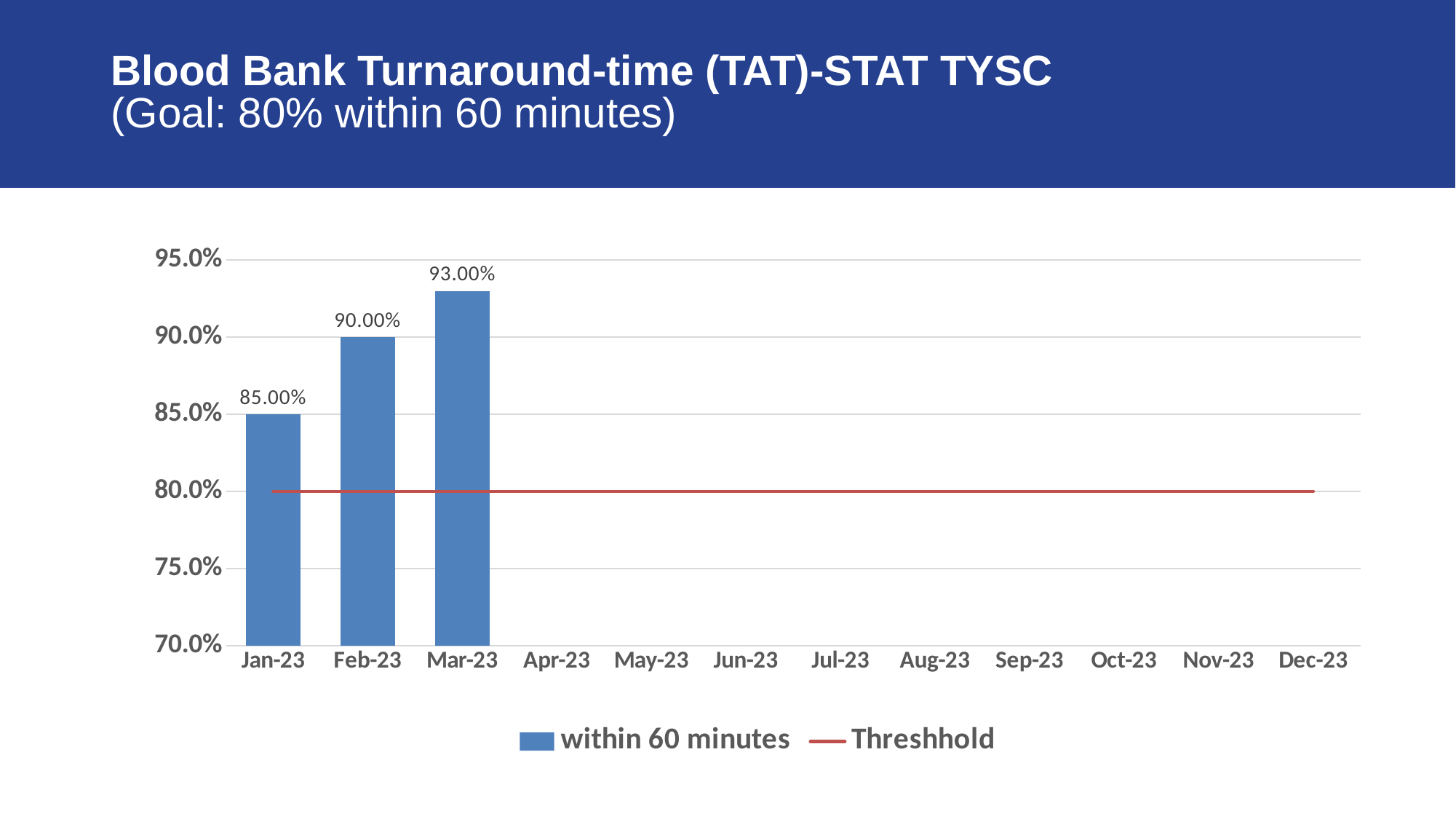
What is the value for Jan-23 in the 'within 60 minutes' series? 85.00% Which is larger, the Feb-23 value or the Jan-23 value? Feb-23 What is the value for Mar-23 in the 'within 60 minutes' series? 93.00% Which month has the highest 'within 60 minutes' value? Mar-23 How many series does the legend list? 2 Is the value for Jan-23 greater or less than 80.0%? greater How many months have a bar plotted on the chart? 3 What is the difference between the Mar-23 and Jan-23 'within 60 minutes' values? 8.00% What kind of chart is used for the 'within 60 minutes' series? Bar chart What is the value for Feb-23 in the 'within 60 minutes' series? 90.00% Which month has the lowest 'within 60 minutes' value among the plotted bars? Jan-23 Do the 'within 60 minutes' values rise or fall from Jan-23 to Mar-23? Rise